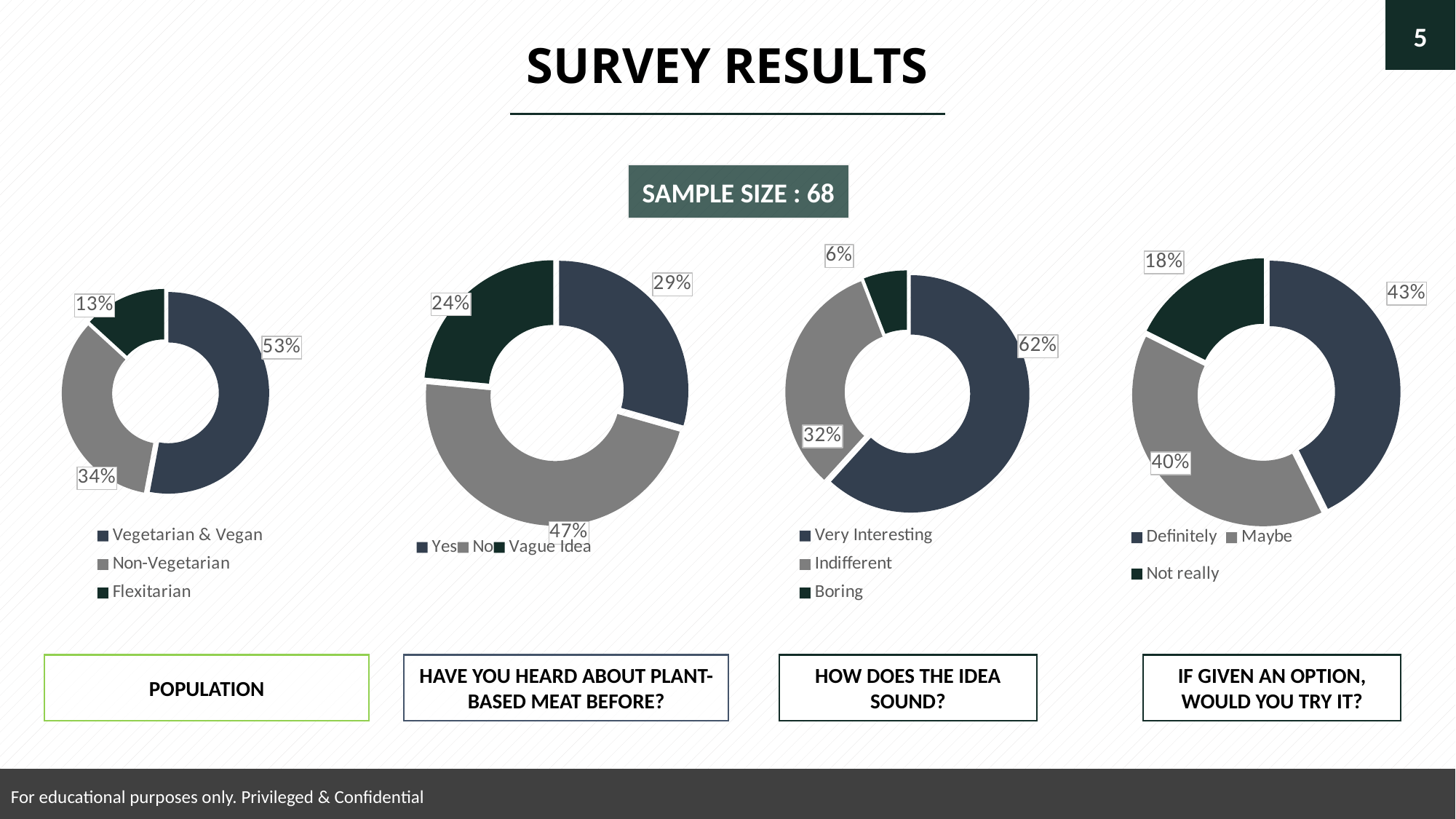
In the POPULATION chart, which category has the largest share? Vegetarian & Vegan In the chart titled IF GIVEN AN OPTION, WOULD YOU TRY IT?, what share answered Not really? 18% In the chart titled IF GIVEN AN OPTION, WOULD YOU TRY IT?, what is the difference in percentage points between Definitely and Not really? 25 How many categories does the legend of the POPULATION chart list? 3 In the chart titled HAVE YOU HEARD ABOUT PLANT-BASED MEAT BEFORE?, what share answered Yes? 29% In the POPULATION chart, which category has the smallest share? Flexitarian In the chart titled HAVE YOU HEARD ABOUT PLANT-BASED MEAT BEFORE?, what is the difference in percentage points between No and Vague Idea? 23 In the chart titled HAVE YOU HEARD ABOUT PLANT-BASED MEAT BEFORE?, which answer has the largest share? No In the POPULATION chart, what share is Non-Vegetarian? 34% In the chart titled HOW DOES THE IDEA SOUND?, which is larger, Very Interesting or Indifferent? Very Interesting In the chart titled HOW DOES THE IDEA SOUND?, what share answered Boring? 6% What kind of chart is the POPULATION chart? doughnut chart